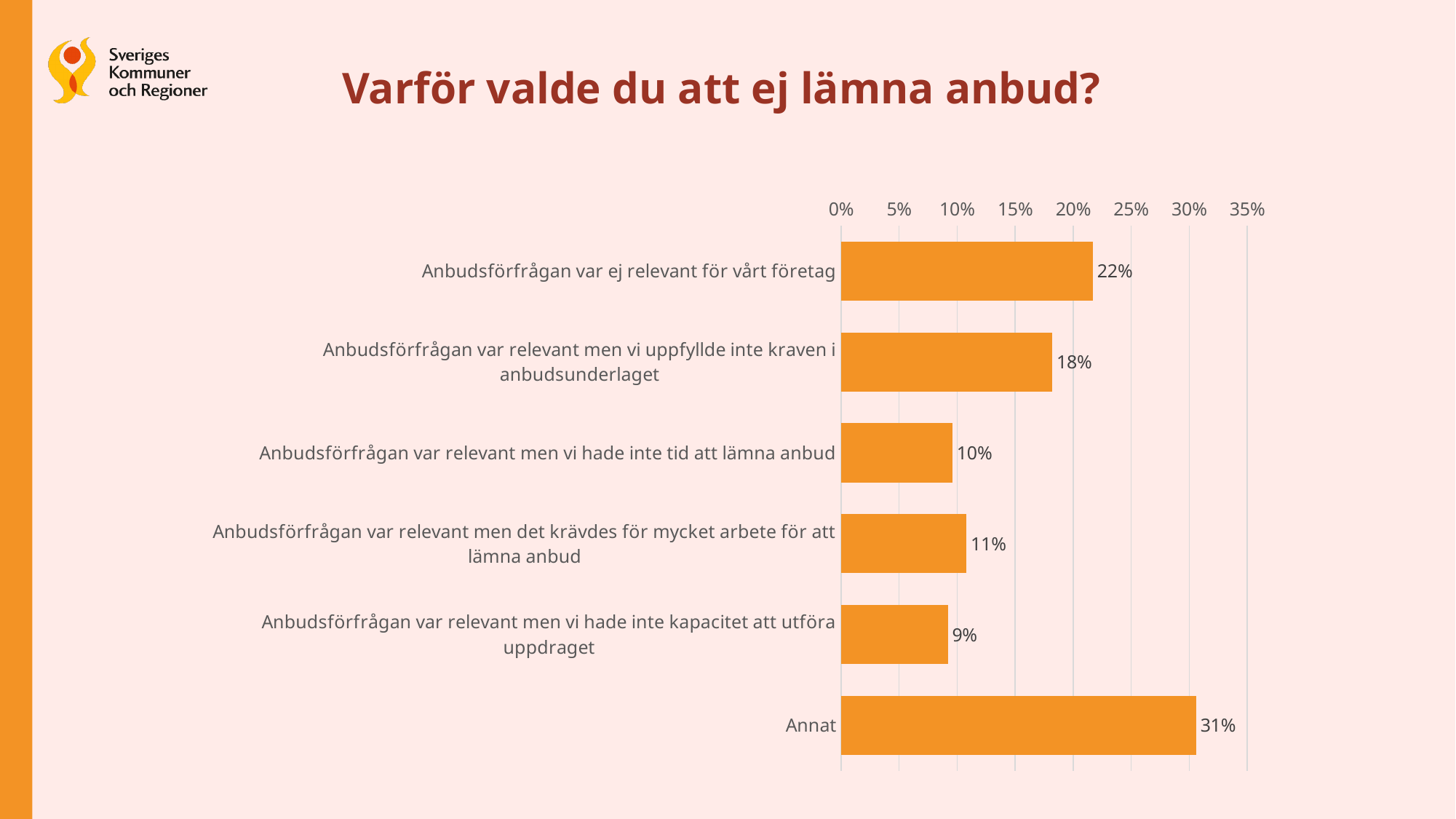
What is the value for "Anbudsförfrågan var relevant men vi hade inte kapacitet att utföra uppdraget"? 9% Which is larger: the value for "Anbudsförfrågan var relevant men vi hade inte tid att lämna anbud" or the value for "Anbudsförfrågan var relevant men det krävdes för mycket arbete för att lämna anbud"? Anbudsförfrågan var relevant men det krävdes för mycket arbete för att lämna anbud What kind of chart is shown on the slide? Bar chart What is the difference between the value for "Annat" and the value for "Anbudsförfrågan var ej relevant för vårt företag"? 9% What is the value for "Anbudsförfrågan var relevant men vi uppfyllde inte kraven i anbudsunderlaget"? 18% How many categories are shown in the chart? 6 Which category has the lowest value? Anbudsförfrågan var relevant men vi hade inte kapacitet att utföra uppdraget What is the value for "Annat"? 31% Which category has the highest value? Annat What is the title of the slide? Varför valde du att ej lämna anbud? Is the value for "Anbudsförfrågan var relevant men vi uppfyllde inte kraven i anbudsunderlaget" greater or less than 15%? greater What is the value for "Anbudsförfrågan var ej relevant för vårt företag"? 22%